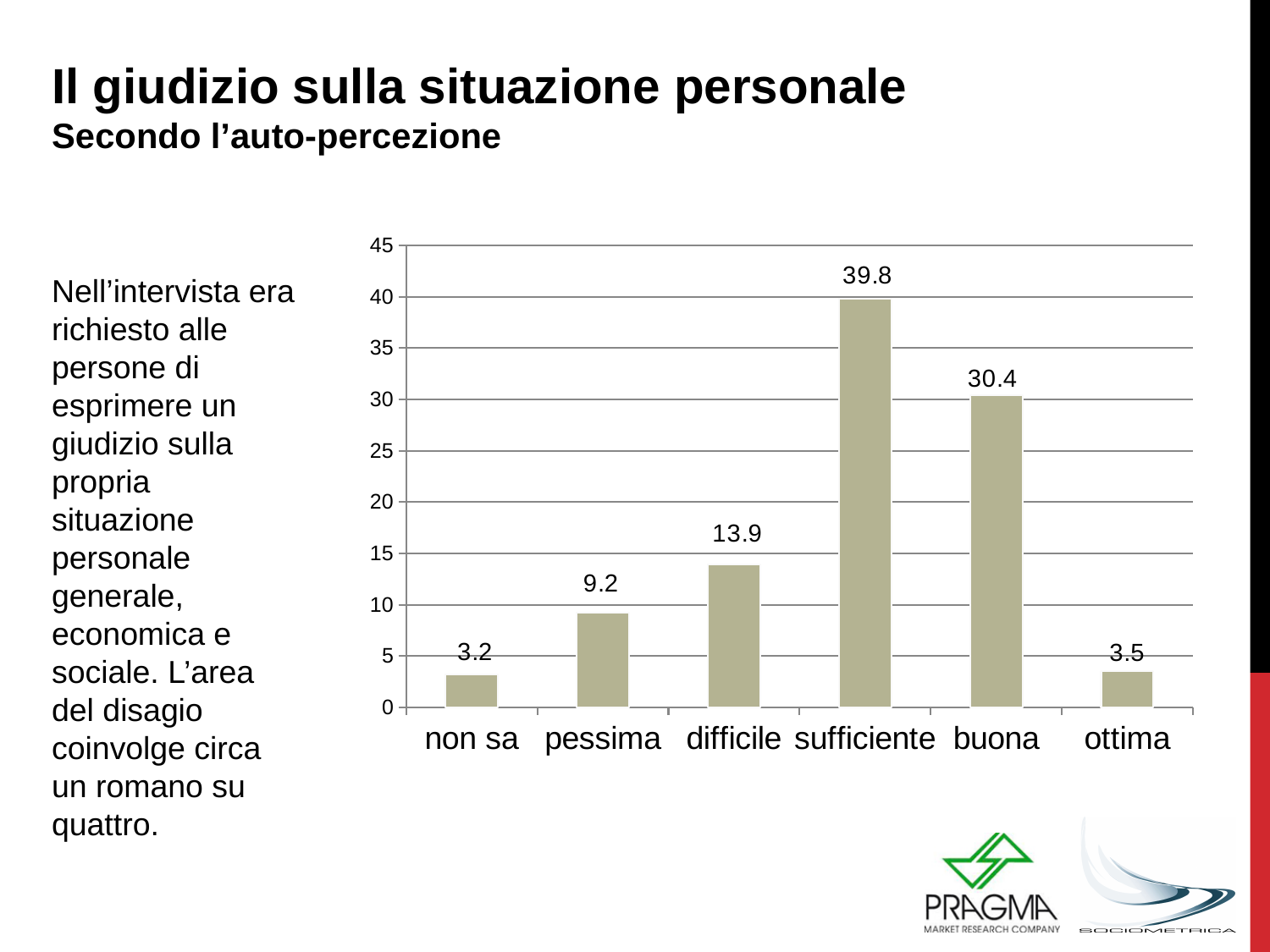
Which category has the highest value? sufficiente What is the value for 'sufficiente'? 39.8 What is the value for 'buona'? 30.4 Which category has the lowest value? non sa Which is larger, the value for 'pessima' or the value for 'ottima'? pessima What is the difference between the values for 'difficile' and 'pessima'? 4.7 Is the value for 'buona' greater or less than 25? greater What is the value for 'difficile'? 13.9 How many categories are shown on the x axis? 6 What kind of chart is shown on the slide? bar chart What is the difference between the values for 'sufficiente' and 'buona'? 9.4 What is the value for 'non sa'? 3.2